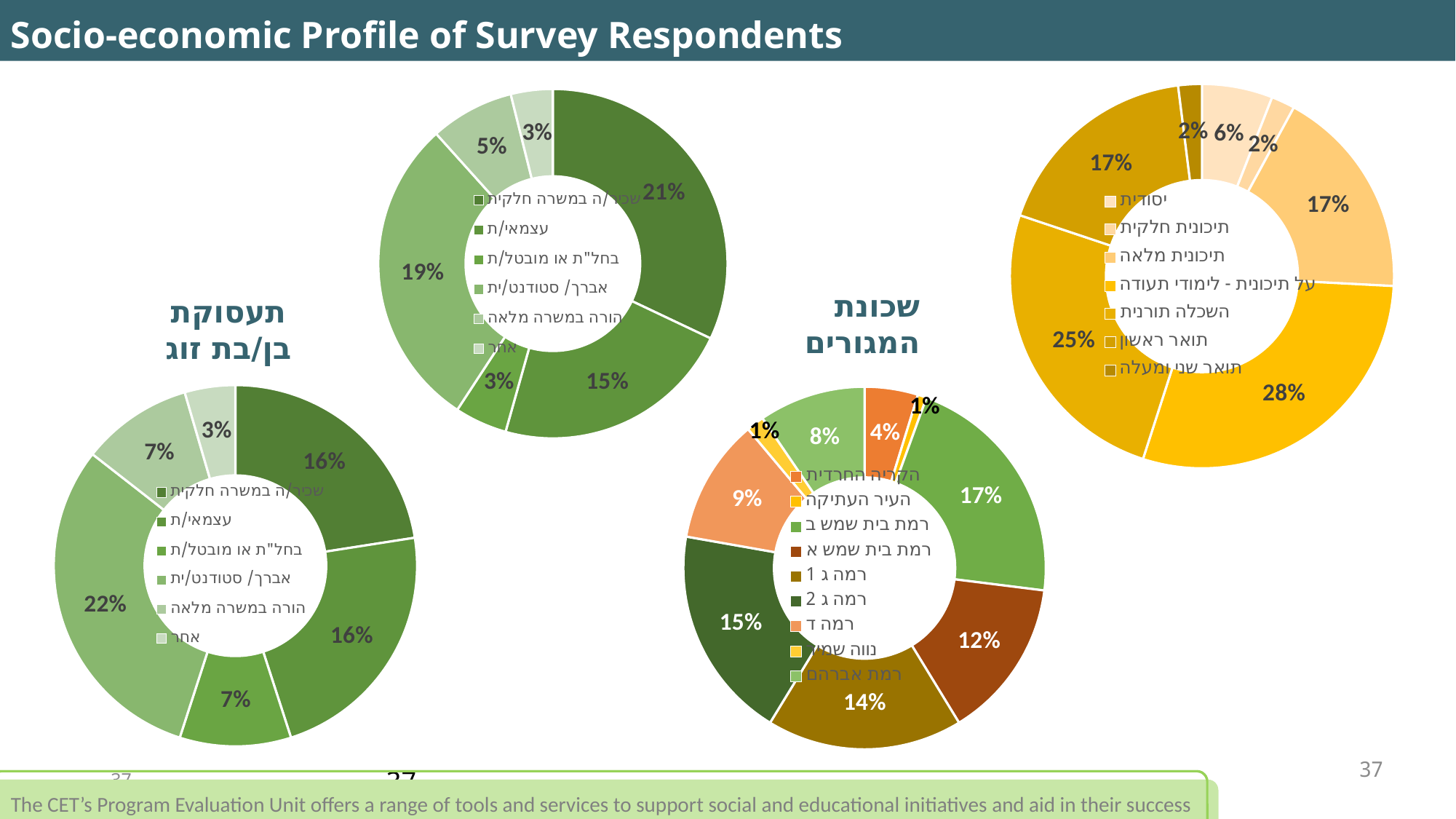
In the chart titled שכונת המגורים, how many entries does the legend list? 9 In the top-right chart (education), what is the largest slice's value? 28% In the chart titled שכונת המגורים, what is the difference between the values for רמה ג 2 and רמה ג 1? 1% What type of chart is the chart titled שכונת המגורים? Pie (donut) chart In the top-center green chart, what is the largest slice's value? 21% In the chart titled שכונת המגורים, what is the value for רמה ד? 9% In the chart titled תעסוקת בן/בת זוג, what is the largest slice's value? 22% In the top-right chart (education), which is larger: the value for תיכונית מלאה or the value for יסודית? תיכונית מלאה In the top-right chart (education), what is the value for השכלה תורנית? 25% In the chart titled שכונת המגורים, what is the value for רמת בית שמש א? 12% How many charts are on the slide? 4